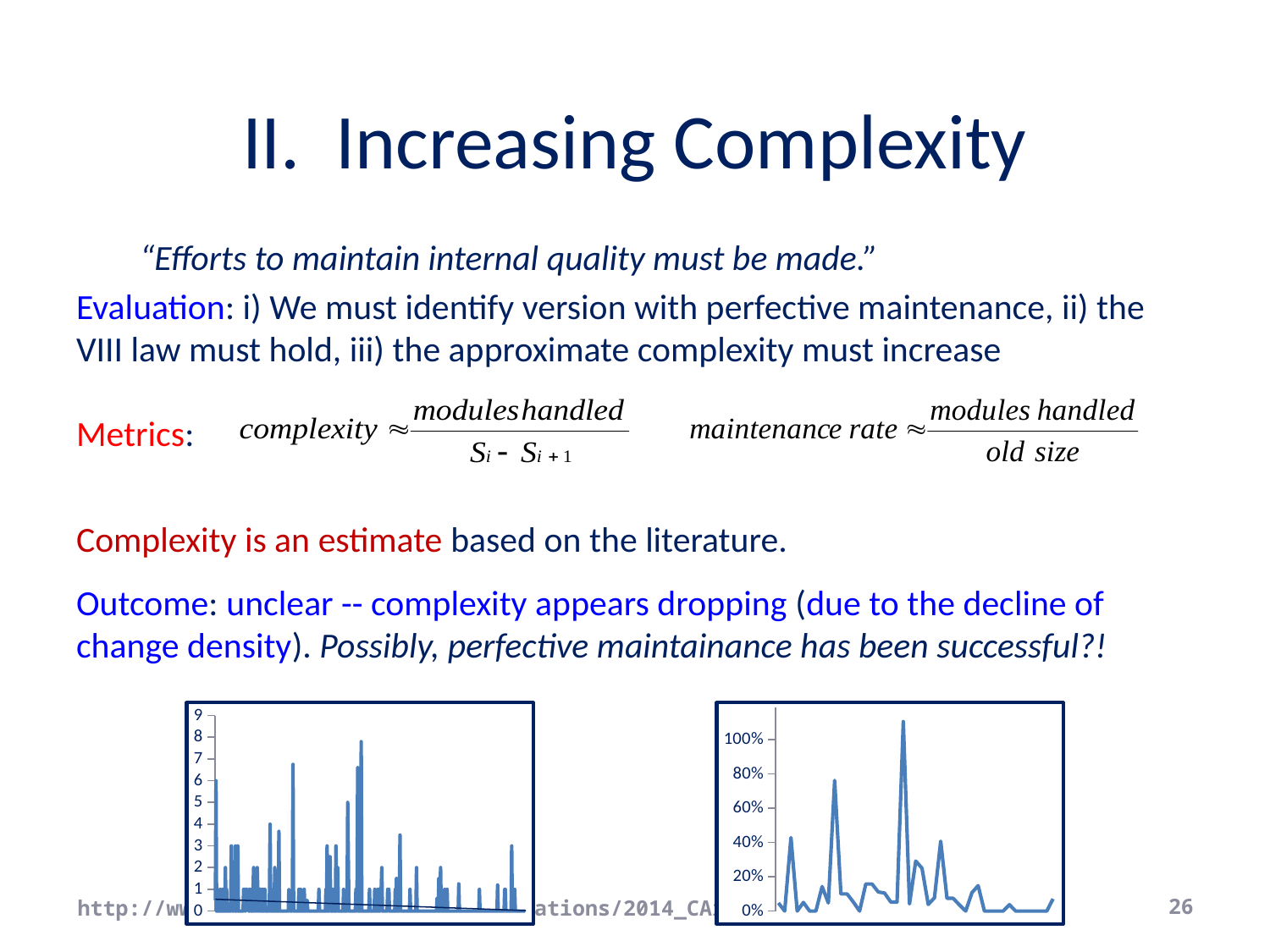
What is the highest tick value shown on the y axis of the left chart? 9 What is the highest tick value shown on the y axis of the right chart? 100% In the right chart, is the highest peak of the line greater or less than 80%? greater In the left chart, does the trend line drawn across the bars rise or fall along the x axis? fall In the right chart, is the highest peak of the line greater or less than 100%? greater What kind of chart is the chart on the right of the slide? line chart What kind of chart is the chart on the left of the slide? bar chart In the left chart, is the tallest bar greater or less than 5? greater